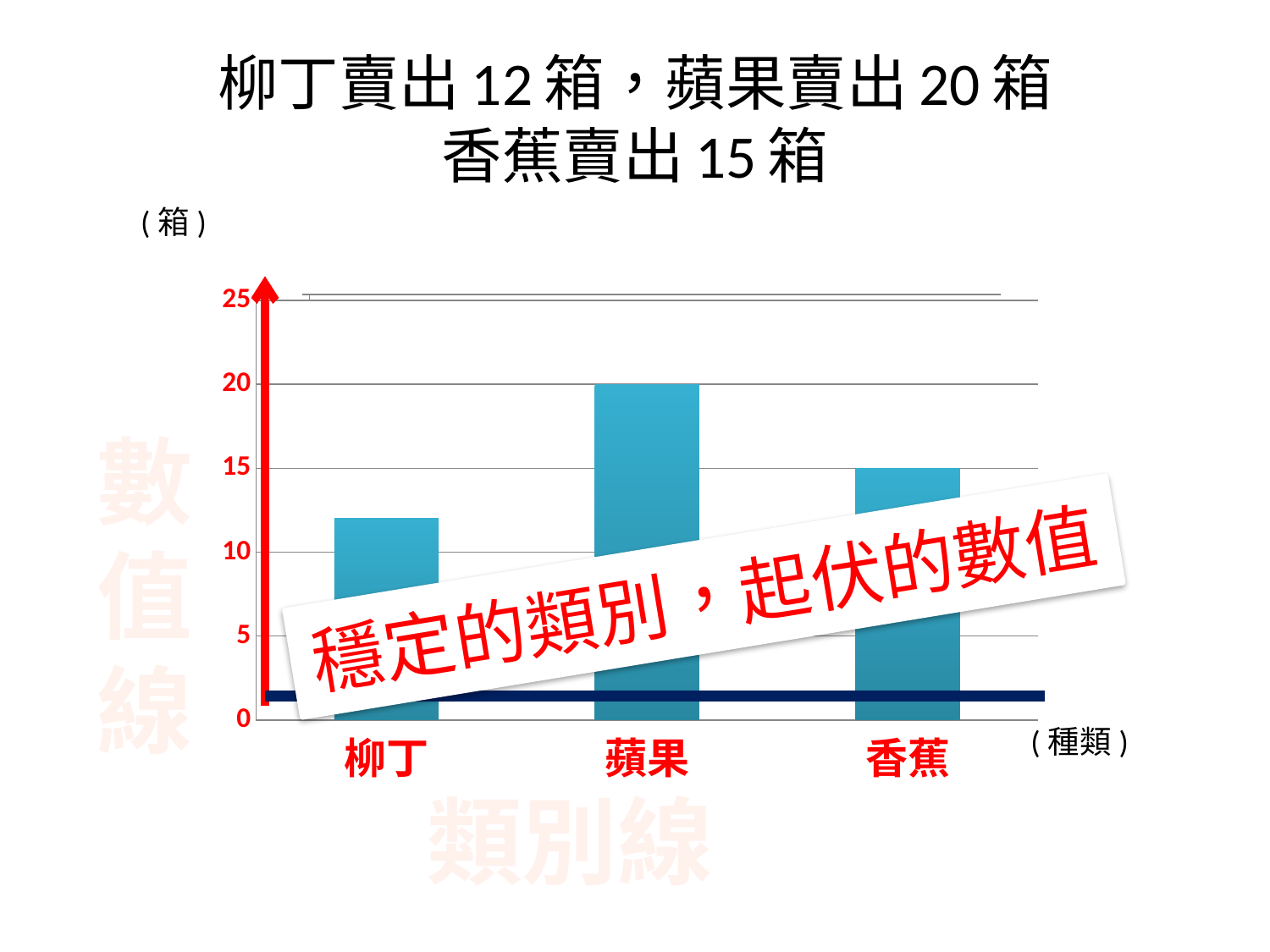
What unit label is shown at the top of the vertical axis? (箱) What is the difference between the values for 蘋果 and 柳丁? 8 Which category has the highest bar? 蘋果 How many boxes of 柳丁 were sold according to the chart? 12 Is the value for 柳丁 greater or less than 10? greater How many categories are plotted on the x axis? 3 What kind of chart is shown on the slide? bar chart Which is larger, the value for 香蕉 or the value for 柳丁? 香蕉 How many boxes of 香蕉 were sold according to the chart? 15 Which category has the lowest bar? 柳丁 How many boxes of 蘋果 were sold according to the chart? 20 What is the difference between the values for 蘋果 and 香蕉? 5